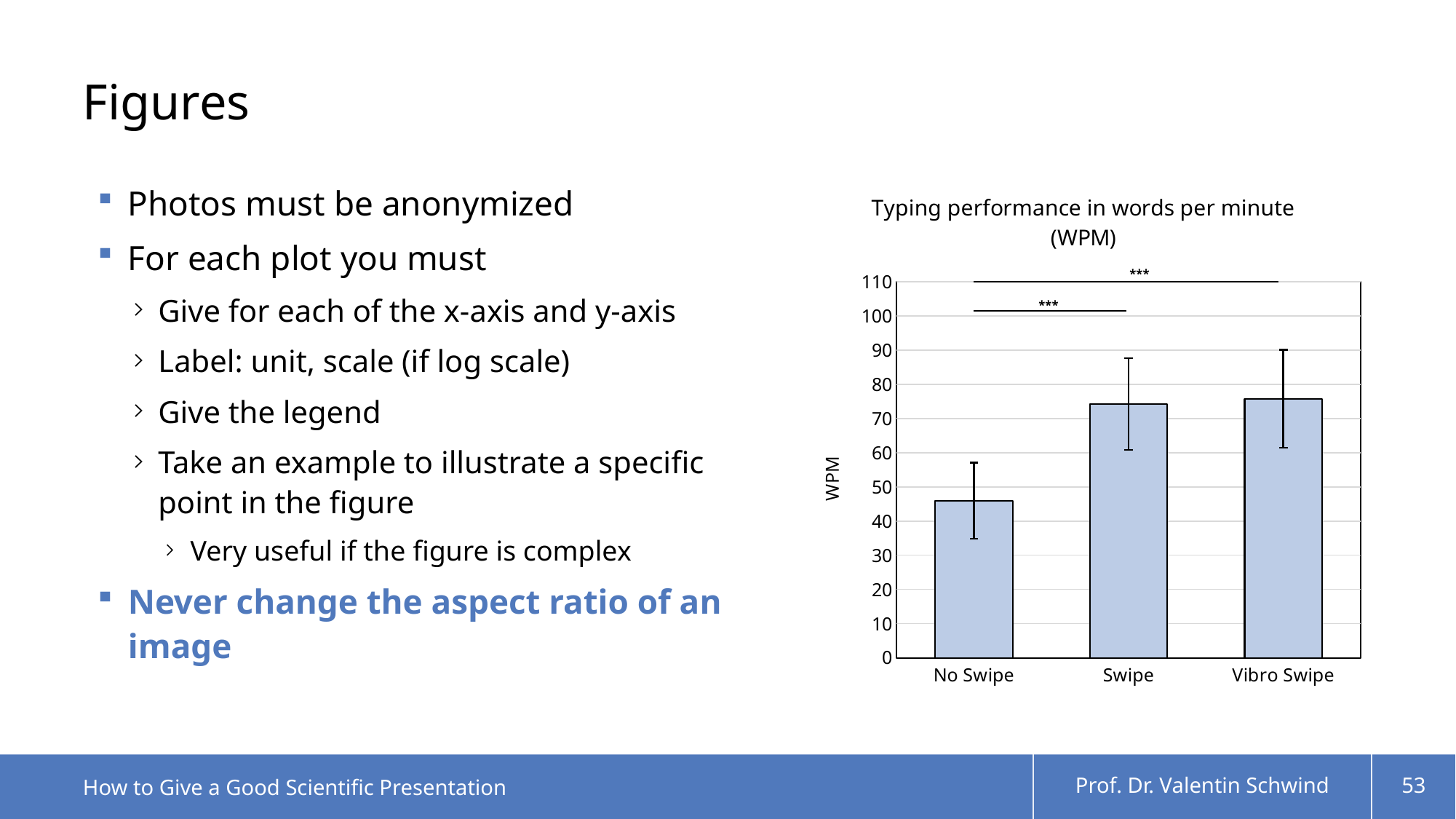
What kind of chart is shown on the slide? bar chart Is the value for Vibro Swipe greater or less than 80? less Is the value for Swipe greater or less than 80? less How many categories are shown on the x axis of the chart? 3 Is the value for No Swipe greater or less than 40? greater Which is larger, the value for No Swipe or the value for Swipe? Swipe What is the label on the y axis of the chart? WPM What is the title of the chart? Typing performance in words per minute (WPM) Which category has the lowest value in the chart? No Swipe